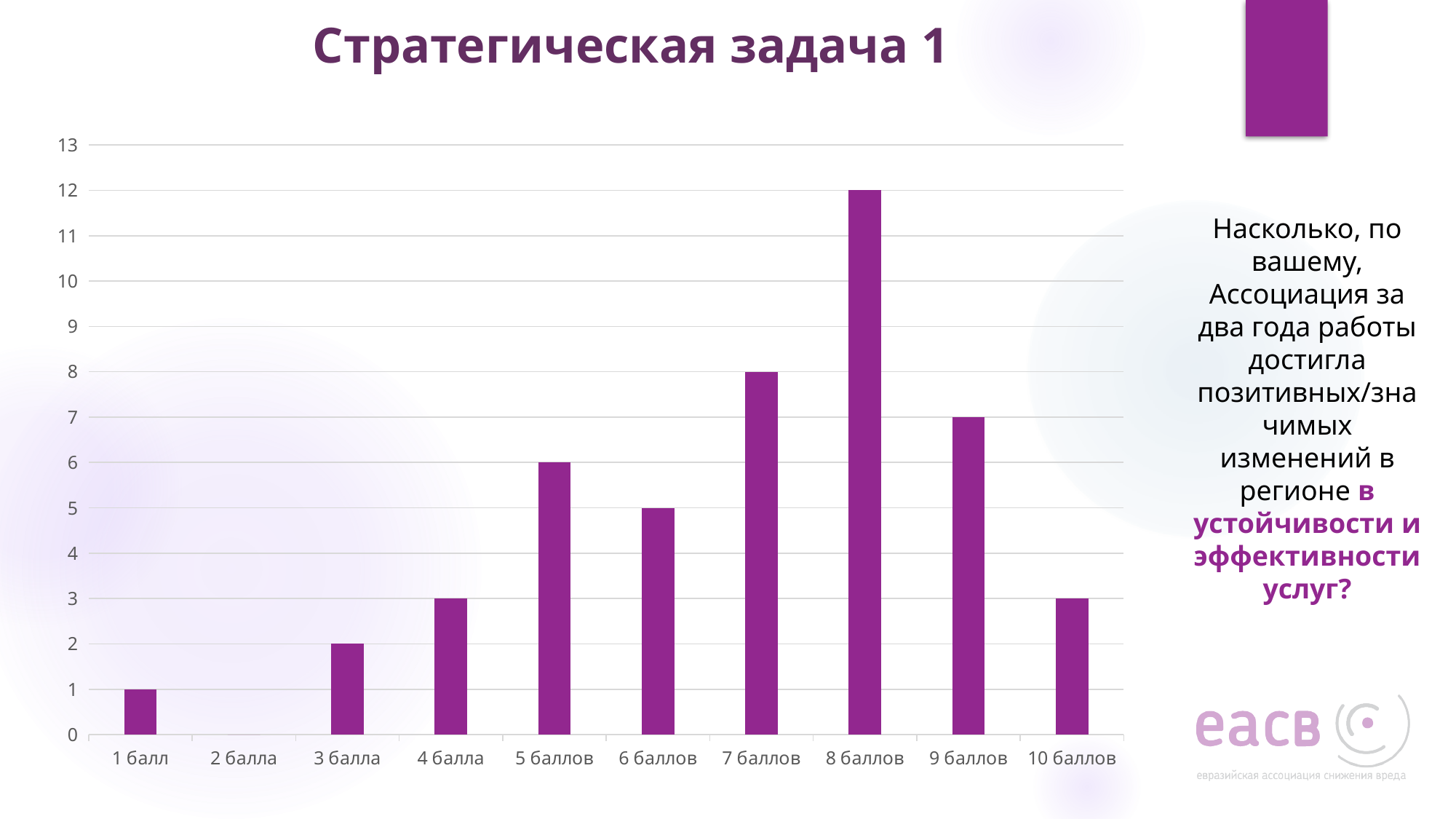
What is the value for 1 балл? 1 What is the difference between the values for 8 баллов and 9 баллов? 5 What is the value for 8 баллов? 12 What is the value for 5 баллов? 6 Is the value for 10 баллов greater or less than 5? less Which is larger, the value for 9 баллов or the value for 6 баллов? 9 баллов What type of chart is shown on the slide? bar chart Which category has no visible bar? 2 балла What is the title of the slide? Стратегическая задача 1 How many categories are shown on the x axis? 10 What is the value for 7 баллов? 8 Which category has the highest bar? 8 баллов